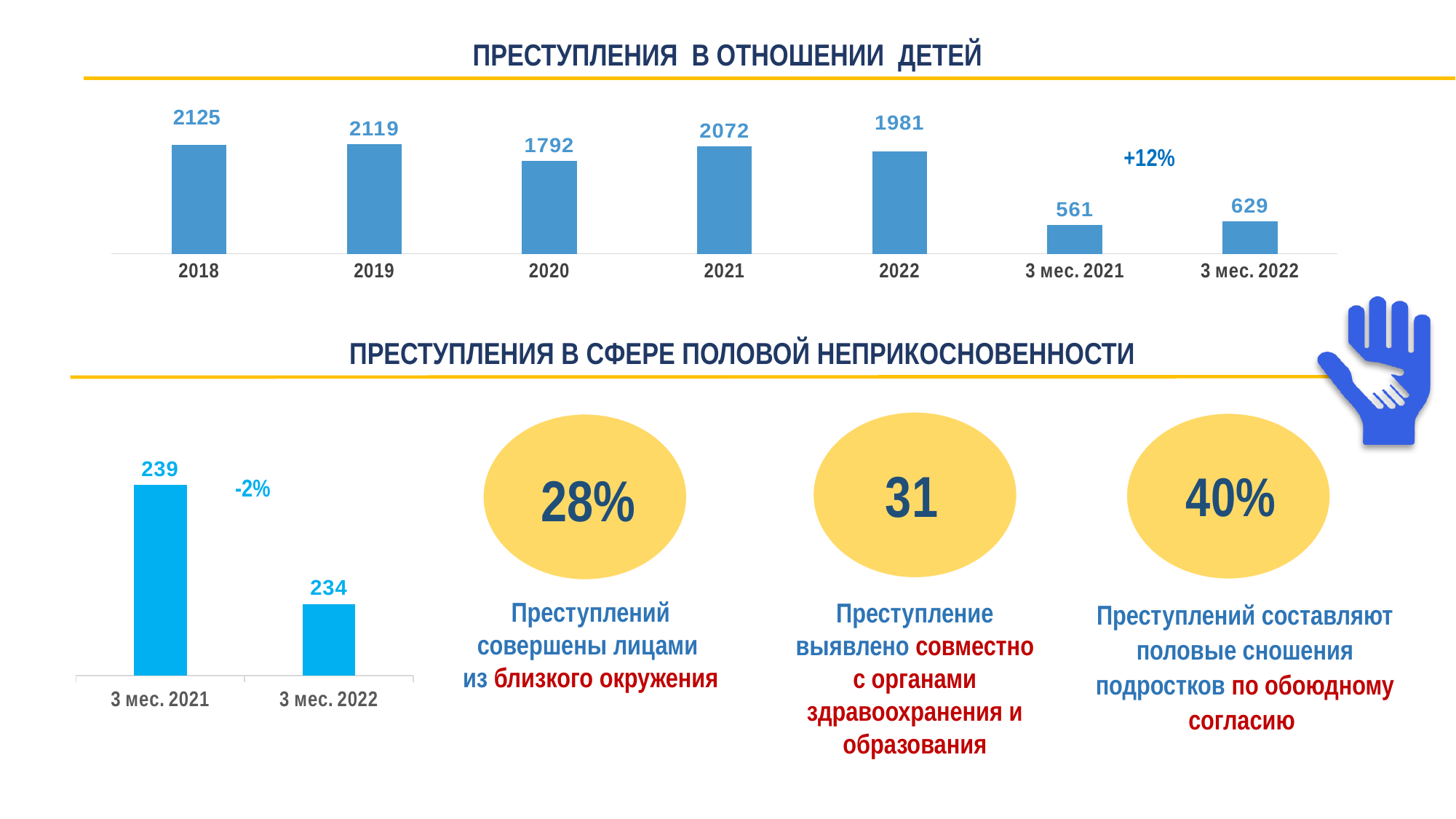
In the chart 'ПРЕСТУПЛЕНИЯ В ОТНОШЕНИИ ДЕТЕЙ', what percentage change is annotated between 3 мес. 2021 and 3 мес. 2022? +12% In the chart 'ПРЕСТУПЛЕНИЯ В СФЕРЕ ПОЛОВОЙ НЕПРИКОСНОВЕННОСТИ', what is the value for 3 мес. 2021? 239 In the chart 'ПРЕСТУПЛЕНИЯ В ОТНОШЕНИИ ДЕТЕЙ', which category has the highest value? 2018 In the chart 'ПРЕСТУПЛЕНИЯ В ОТНОШЕНИИ ДЕТЕЙ', what is the value for 3 мес. 2022? 629 In the chart 'ПРЕСТУПЛЕНИЯ В ОТНОШЕНИИ ДЕТЕЙ', which category has the lowest value? 3 мес. 2021 How many bars are shown in the chart 'ПРЕСТУПЛЕНИЯ В ОТНОШЕНИИ ДЕТЕЙ'? 7 In the chart 'ПРЕСТУПЛЕНИЯ В ОТНОШЕНИИ ДЕТЕЙ', what is the value for 2020? 1792 In the chart 'ПРЕСТУПЛЕНИЯ В ОТНОШЕНИИ ДЕТЕЙ', what is the difference between the values for 2021 and 2022? 91 In the chart 'ПРЕСТУПЛЕНИЯ В СФЕРЕ ПОЛОВОЙ НЕПРИКОСНОВЕННОСТИ', what is the difference between the values for 3 мес. 2021 and 3 мес. 2022? 5 In the chart 'ПРЕСТУПЛЕНИЯ В ОТНОШЕНИИ ДЕТЕЙ', which is larger, the value for 2019 or the value for 2021? 2019 In the chart 'ПРЕСТУПЛЕНИЯ В СФЕРЕ ПОЛОВОЙ НЕПРИКОСНОВЕННОСТИ', do the values rise or fall from 3 мес. 2021 to 3 мес. 2022? Fall What type of chart is 'ПРЕСТУПЛЕНИЯ В ОТНОШЕНИИ ДЕТЕЙ'? Bar chart